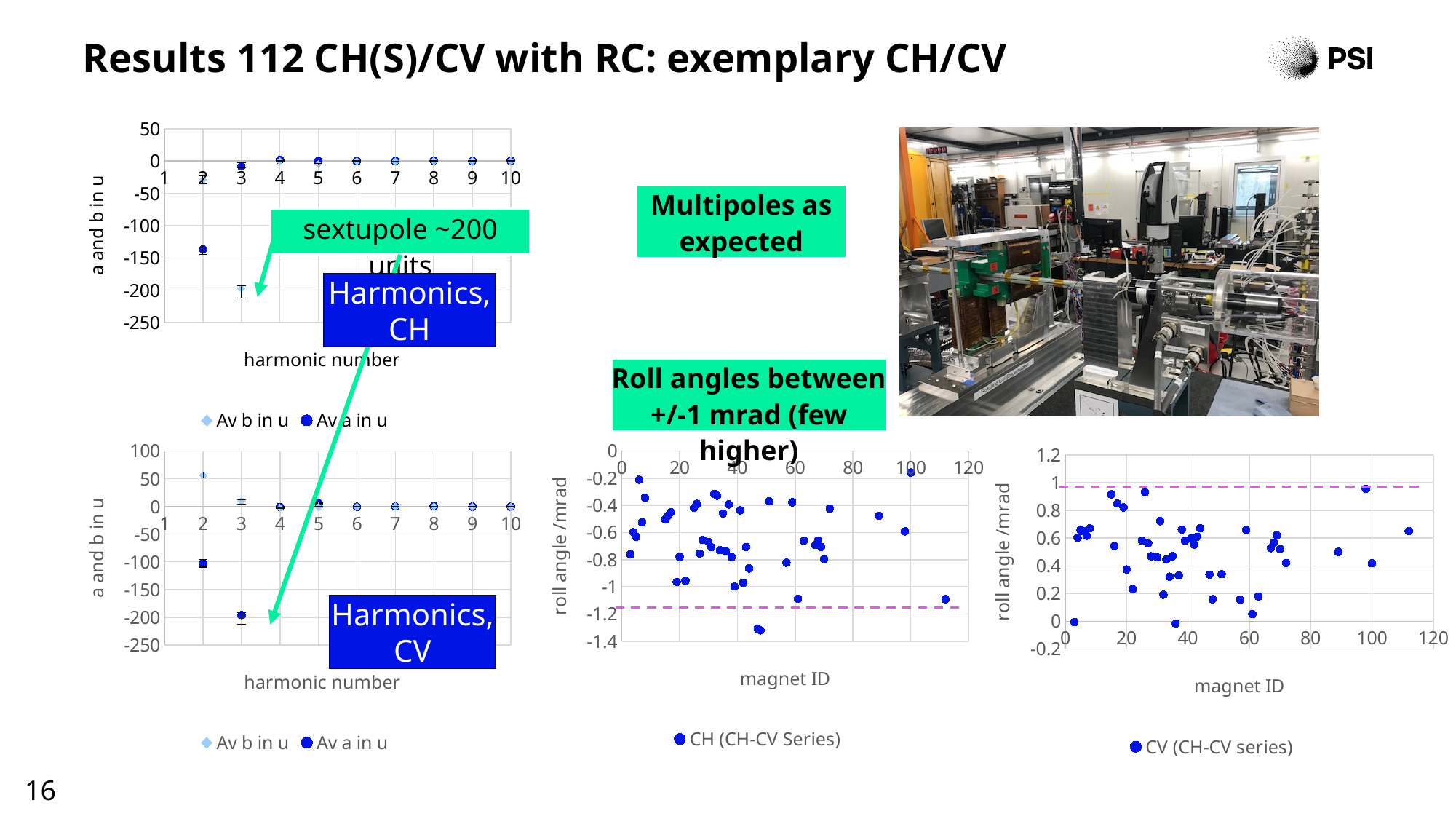
What kind of chart is the Harmonics, CH chart (top left)? scatter chart In the CV roll angle chart (far right), is the highest plotted roll angle greater or less than 0.8? greater What is the legend entry of the CH roll angle chart (middle right)? CH (CH-CV Series) In the Harmonics, CV chart, which harmonic number has the highest Av b in u value? 2 In the Harmonics, CH chart, which harmonic number has the lowest Av a in u value? 2 How many series does the legend of the CV roll angle chart (far right) list? 1 In the Harmonics, CV chart, which harmonic number has the lowest Av a in u value? 3 In the Harmonics, CV chart, is the Av a in u value at harmonic number 3 greater or less than -150? less In the CH roll angle chart (middle right), is the lowest plotted roll angle greater or less than -1.2? less How many series does the legend of the Harmonics, CH chart list? 2 How many harmonic numbers are shown on the x axis of the Harmonics, CV chart? 10